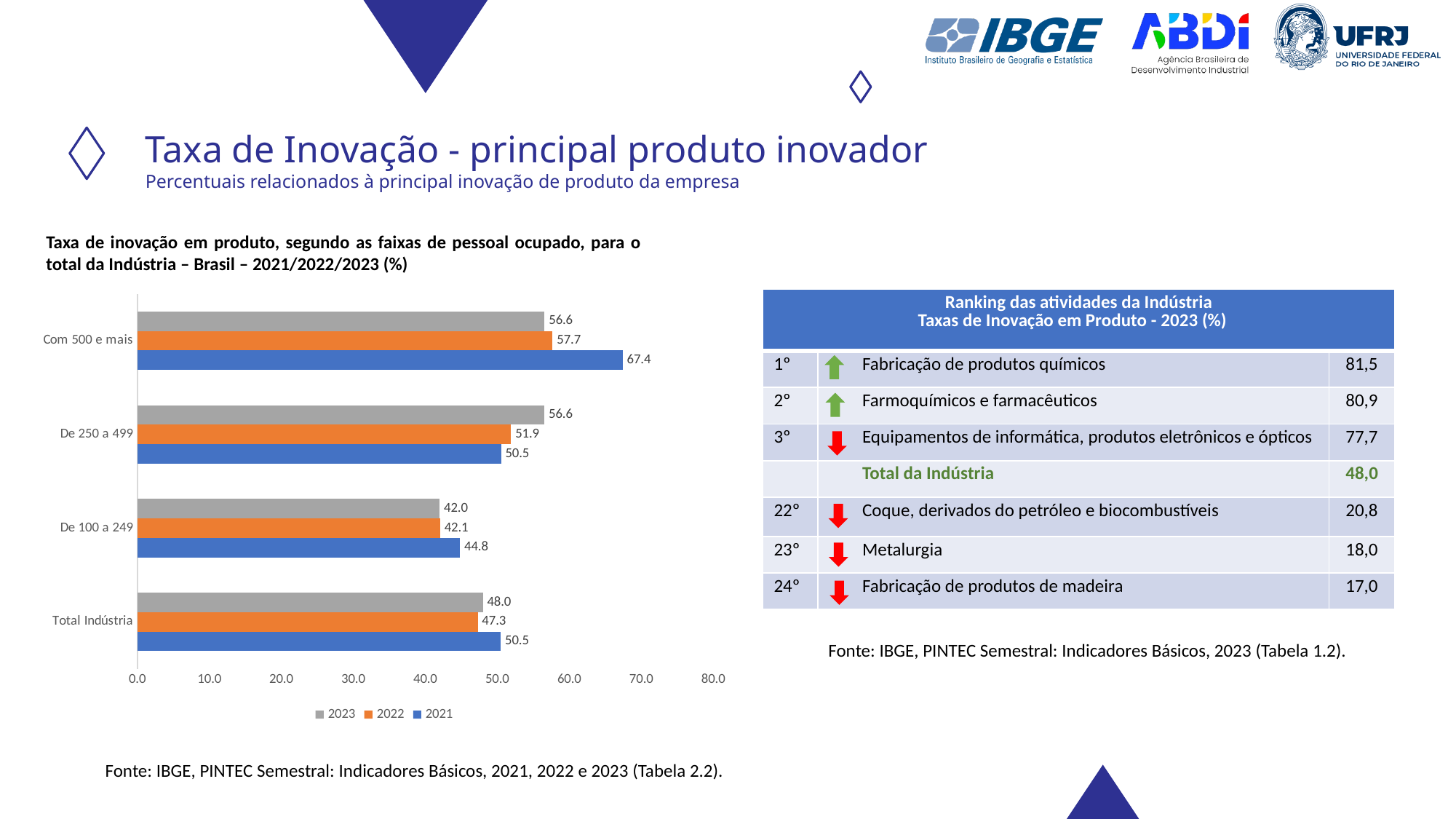
Which is larger for "De 250 a 499": the 2023 value or the 2021 value? 2023 What is the difference between the 2021 and 2022 values for "Total Indústria"? 3.2 What is the 2021 value for "Com 500 e mais"? 67.4 What is the difference between the 2021 and 2023 values for "Com 500 e mais"? 10.8 What kind of chart is shown on the slide? Bar chart Which colour represents the 2022 series in the chart? Orange What is the 2022 value for "De 250 a 499"? 51.9 How many categories (faixas de pessoal ocupado) are shown on the chart? 4 Which category has the highest 2021 value? Com 500 e mais What is the 2023 value for "Total Indústria"? 48.0 How many series does the chart legend list? 3 Which category has the lowest 2023 value? De 100 a 249